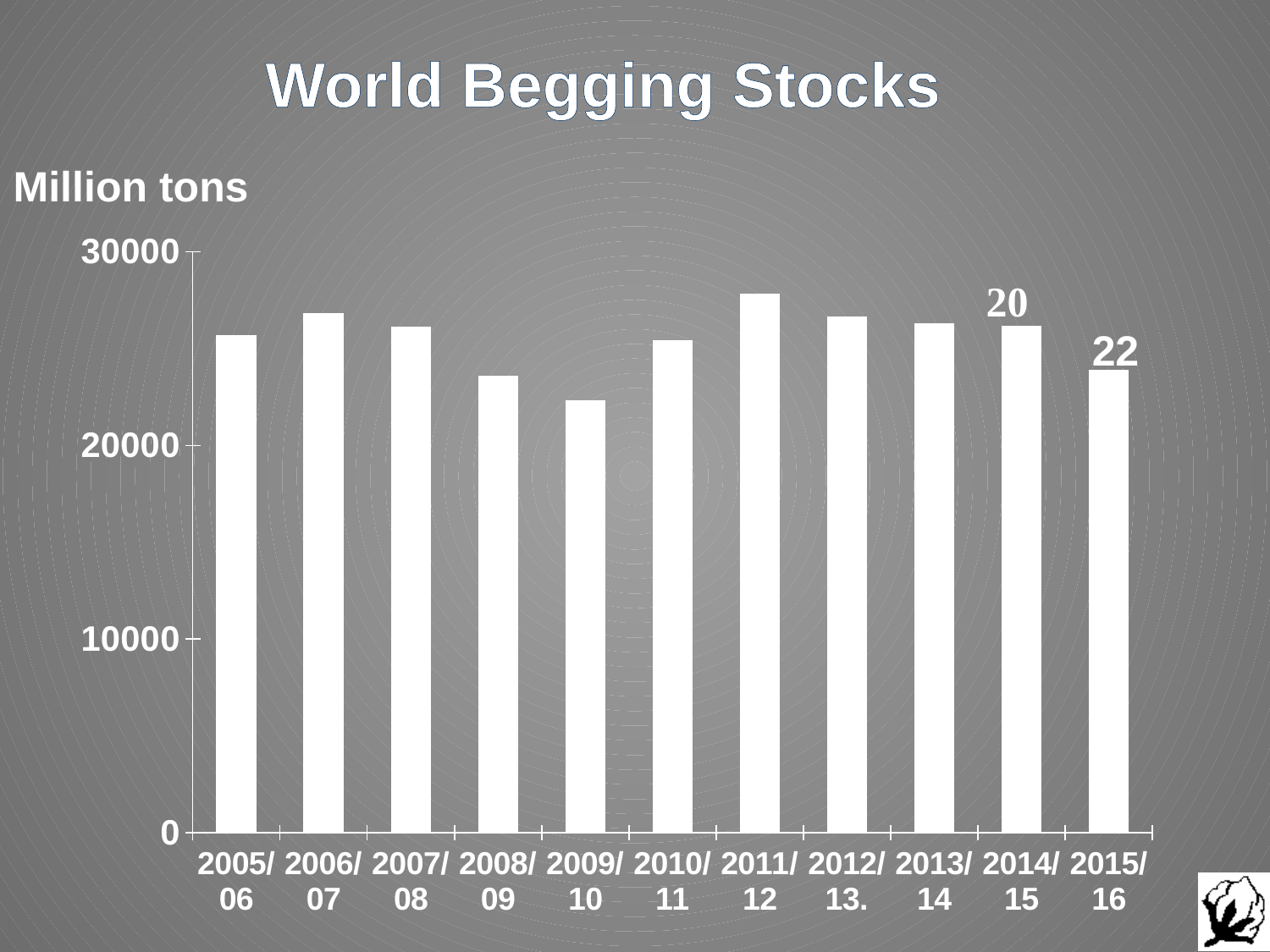
What kind of chart is shown on the slide? bar chart Which is larger, the value for 2006/07 or the value for 2008/09? 2006/07 How many seasons (bars) are plotted on the chart? 11 Which is larger, the value for 2009/10 or the value for 2012/13? 2012/13 Is the value for 2011/12 greater or less than 20000? greater What unit is shown above the vertical axis of the chart? Million tons What is the title of the chart? World Begging Stocks Which season has the lowest world beginning stocks? 2009/10 Do the values rise or fall from 2006/07 to 2009/10? fall Is the value for 2009/10 greater or less than 30000? less Which season has the highest world beginning stocks? 2011/12 Is the value for 2008/09 greater or less than 20000? greater